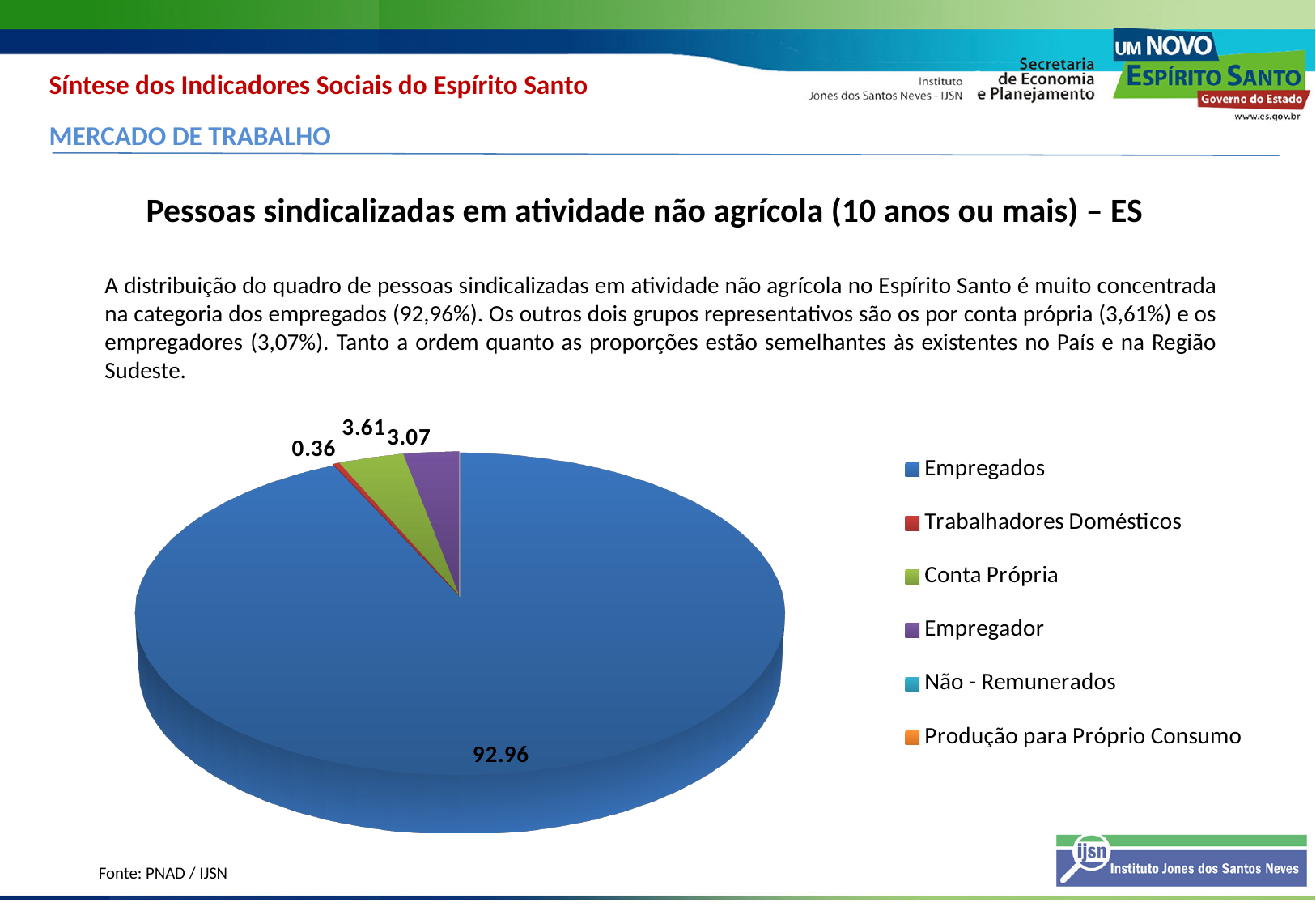
Which category has the largest slice of the pie chart? Empregados What is the value shown for Trabalhadores Domésticos in the pie chart? 0.36 How many entries does the legend of the pie chart list? 6 What is the difference between the values for Conta Própria and Empregador? 0.54 Which is larger in the pie chart, Conta Própria or Empregador? Conta Própria What is the value shown for Empregados in the pie chart? 92.96 What kind of chart is shown on the slide? pie chart What is the difference between the values for Empregados and Conta Própria? 89.35 What is the value shown for Empregador in the pie chart? 3.07 What is the value shown for Conta Própria in the pie chart? 3.61 What is the title of the chart on the slide? Pessoas sindicalizadas em atividade não agrícola (10 anos ou mais) – ES What colour is the Empregados slice in the pie chart? blue